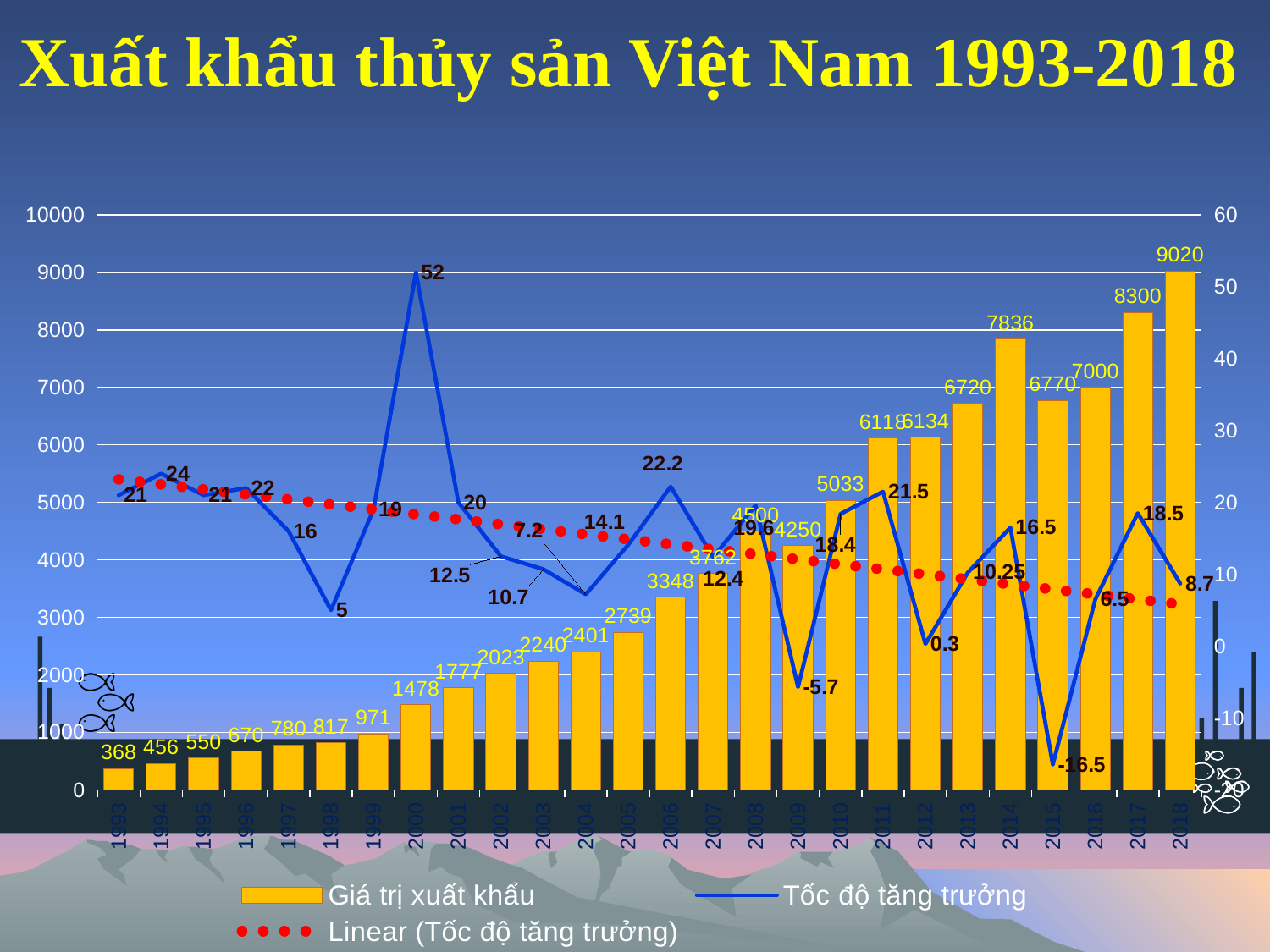
What is the export value for 2010? 5033 What is the export value (Giá trị xuất khẩu) for 2018? 9020 What kind of chart is this? Combined bar and line chart How many years are shown on the x axis? 26 In which year is the growth rate (Tốc độ tăng trưởng) highest? 2000 Which year has the larger export value, 2014 or 2015? 2014 Do the export values (Giá trị xuất khẩu) generally rise or fall from 1993 to 2018? Rise What is the growth rate (Tốc độ tăng trưởng) for 2000? 52 How many series does the legend list? 3 In which year is the growth rate (Tốc độ tăng trưởng) lowest? 2015 In which year is the export value (Giá trị xuất khẩu) lowest? 1993 What is the difference between the export values for 2018 and 2017? 720